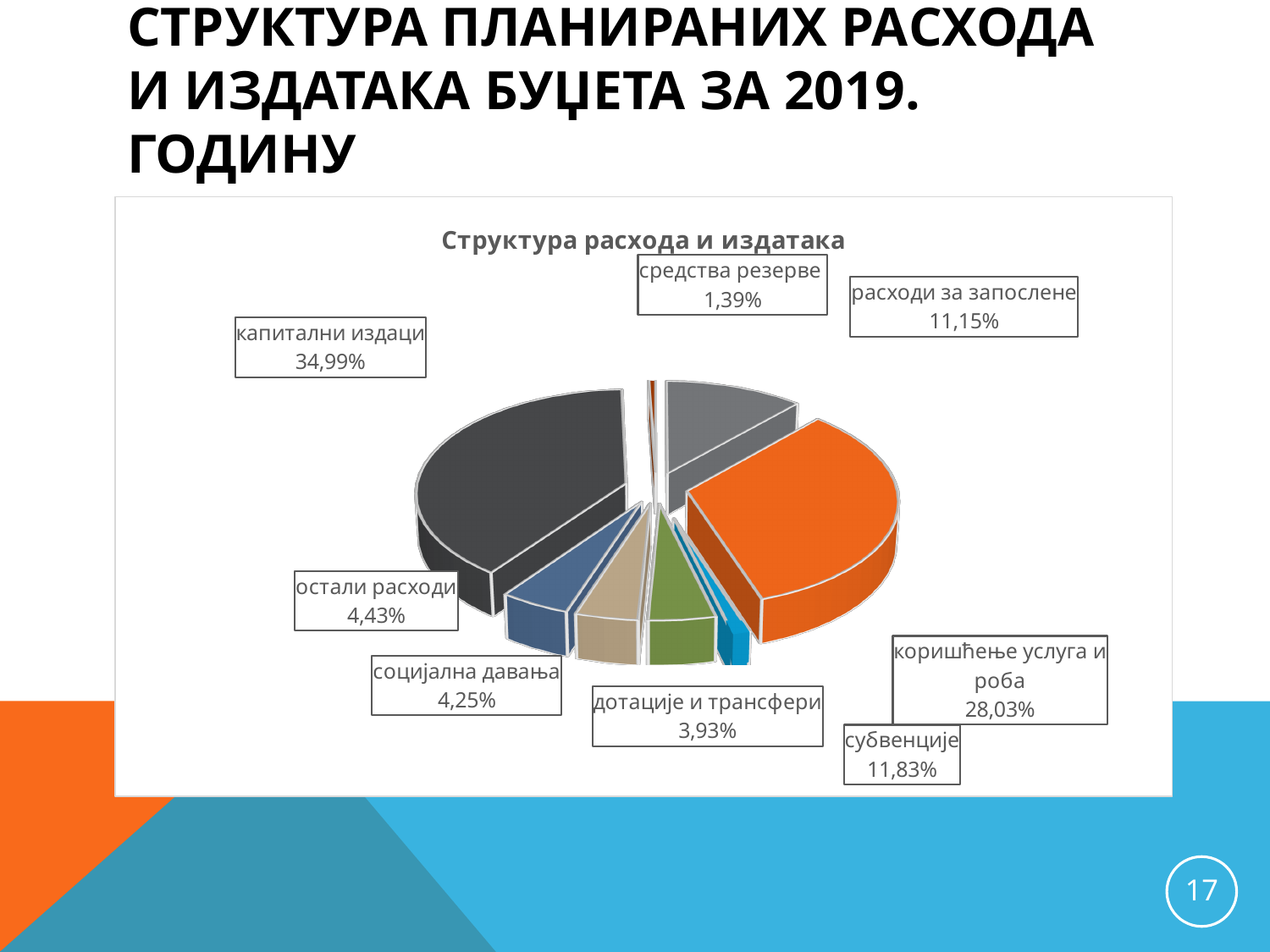
How many categories (slices) does the pie chart have? 8 What is the difference between the shares of остали расходи and социјална давања? 0,18% What is the title of the chart? Структура расхода и издатака What is the value shown for субвенције? 11,83% What is the value shown for средства резерве? 1,39% Which category has the smallest share of the pie? средства резерве What share of the pie is коришћење услуга и роба? 28,03% Which category has the largest share of the pie? капитални издаци Which is larger, субвенције or расходи за запослене? субвенције What is the difference between the shares of капитални издаци and коришћење услуга и роба? 6,96% What type of chart is shown on the slide? pie chart What share of the pie is капитални издаци? 34,99%